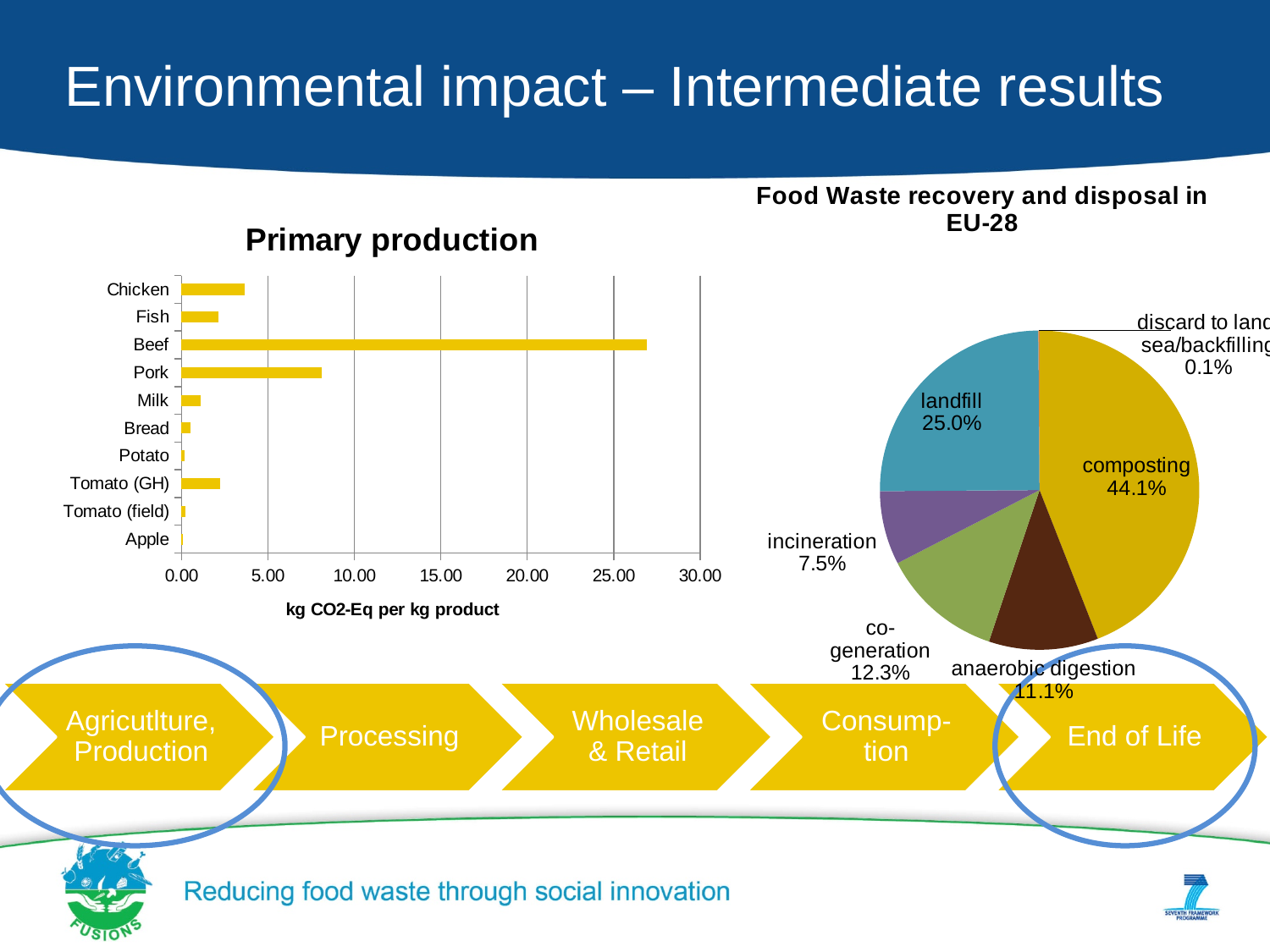
In the 'Primary production' chart, which product has the highest kg CO2-Eq per kg product? Beef In the 'Primary production' chart, is the value for Pork greater or less than 10.00? less In the 'Primary production' chart, which is larger, the value for Pork or the value for Chicken? Pork In the 'Food Waste recovery and disposal in EU-28' pie chart, what share is composting? 44.1% In the 'Food Waste recovery and disposal in EU-28' pie chart, how many percentage points larger is composting than landfill? 19.1% In the 'Food Waste recovery and disposal in EU-28' pie chart, what share is anaerobic digestion? 11.1% In the 'Food Waste recovery and disposal in EU-28' pie chart, how many slices are there? 6 In the 'Primary production' chart, is the value for Beef greater or less than 25.00? greater In the 'Food Waste recovery and disposal in EU-28' pie chart, what share is landfill? 25.0% In the 'Food Waste recovery and disposal in EU-28' pie chart, which category has the largest share? composting In the 'Primary production' chart, how many products are listed? 10 In the 'Food Waste recovery and disposal in EU-28' pie chart, which category has the smallest share? discard to land/sea/backfilling